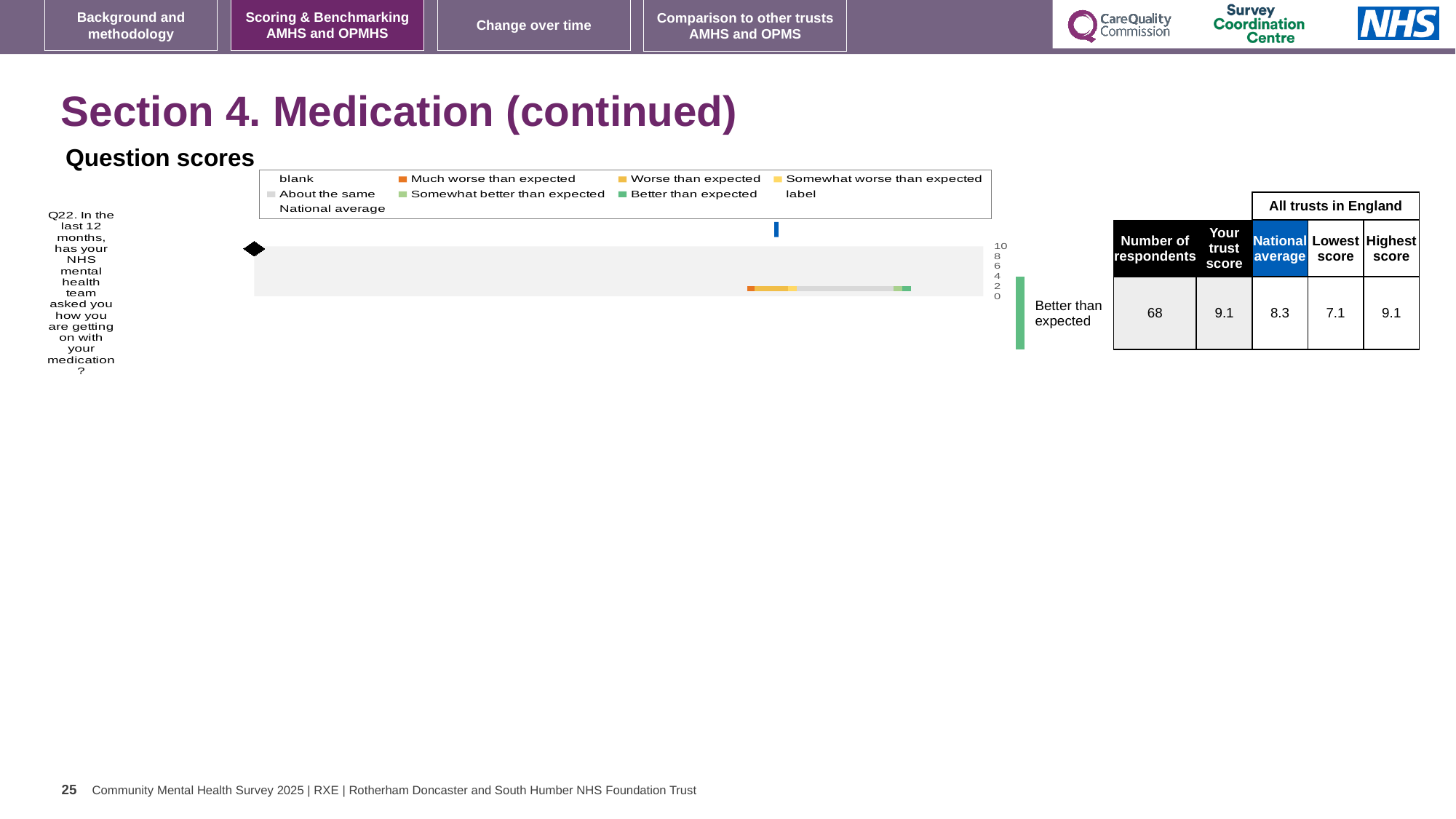
What kind of chart is shown under 'Question scores'? Bar chart How many entries does the legend of the Question scores chart list? 9 What rating label is shown beside the Question scores chart for Q22? Better than expected For Q22, which is larger: the trust's score or the national average? The trust's score Which legend entry in the Question scores chart is shown in orange? Much worse than expected For Q22, what is the difference between the trust's score and the national average? 0.8 Which question is plotted in the Question scores chart? Q22. In the last 12 months, has your NHS mental health team asked you how you are getting on with your medication? According to the table beside the Question scores chart, what is the national average for Q22? 8.3 How many questions (categories) are plotted in the Question scores chart? 1 According to the table beside the Question scores chart, what is the lowest score among all trusts in England for Q22? 7.1 According to the table beside the Question scores chart, what is the trust's score for Q22? 9.1 According to the table beside the Question scores chart, how many respondents answered Q22? 68